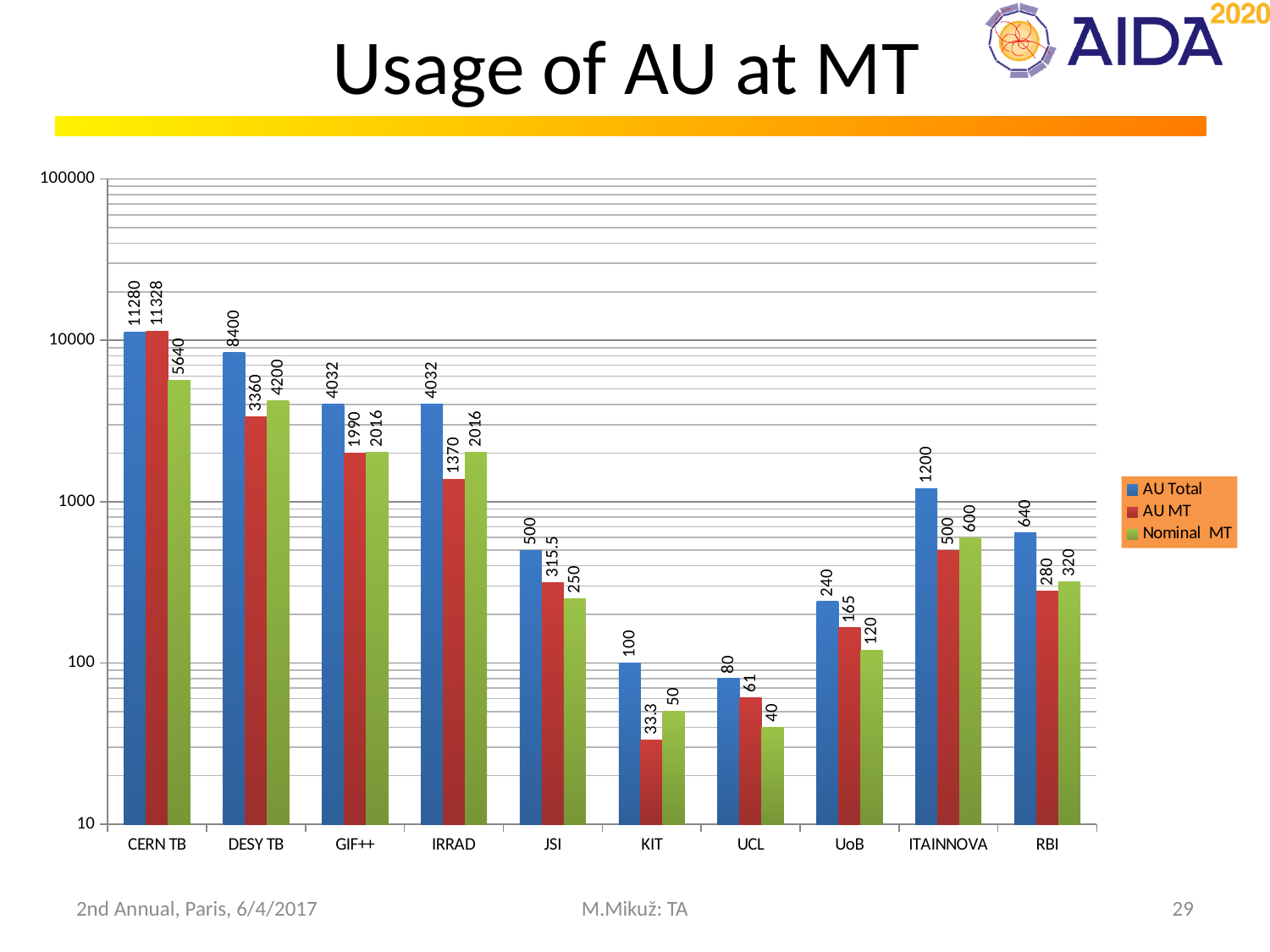
Is the AU Total value for RBI greater or less than 1000? less Which category has the highest AU Total value? CERN TB What is the Nominal MT value for ITAINNOVA? 600 How many series does the legend list? 3 What is the AU MT value for JSI? 315.5 Which category has the lowest AU MT value? KIT What is the difference between the AU Total and AU MT values for IRRAD? 2662 Which is larger for UCL: the AU MT value or the Nominal MT value? AU MT What is the AU Total value for DESY TB? 8400 What kind of chart is shown on the slide? bar chart What is the title of the slide? Usage of AU at MT How many categories are shown on the x axis? 10